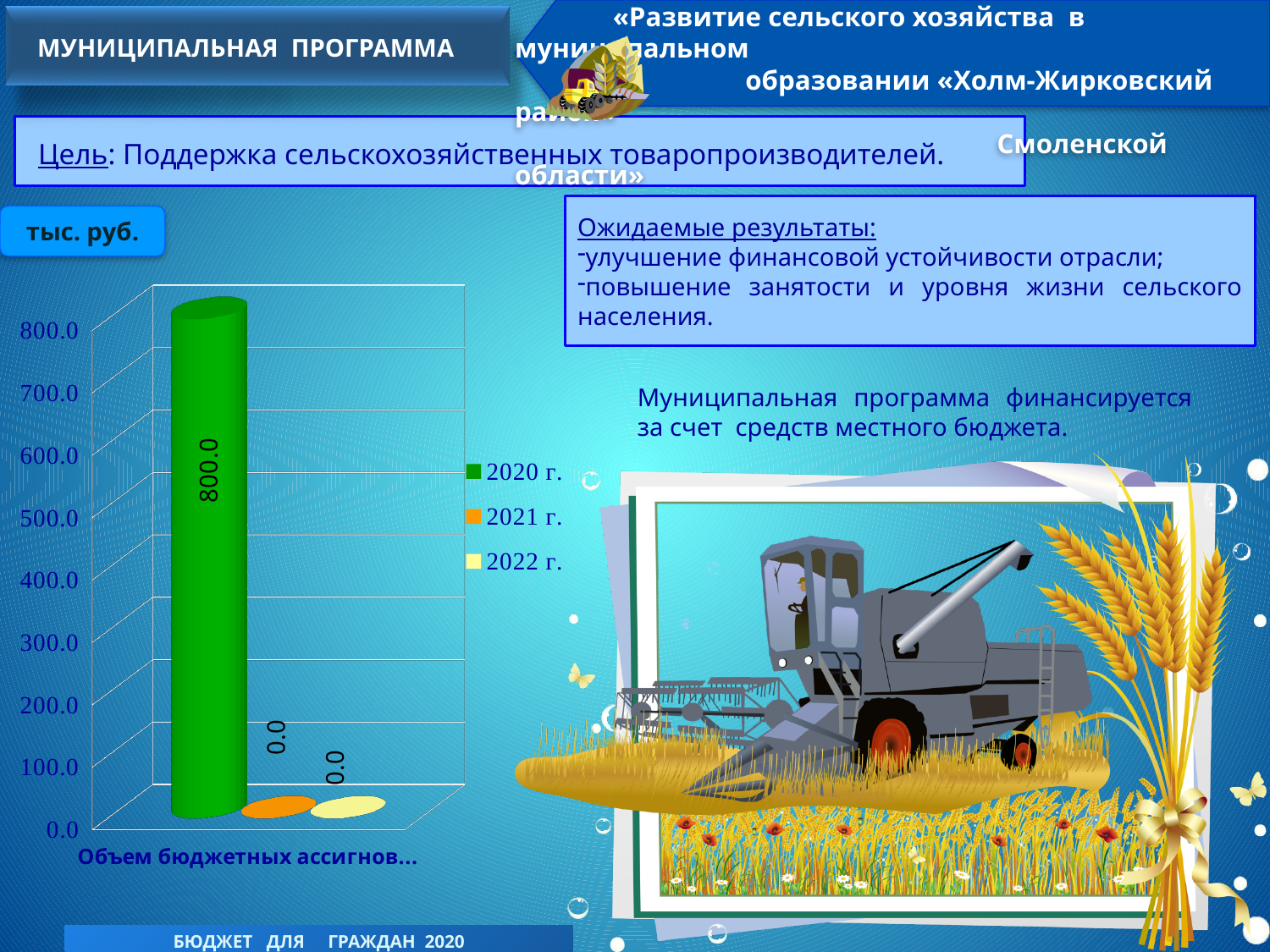
What kind of chart is shown on the slide? bar chart How many series does the chart legend list? 3 Which series has the highest value in the chart? 2020 г. What is the value for the 2022 г. series in the chart? 0.0 What is the value for the 2021 г. series in the chart? 0.0 What is the value for the 2020 г. series in the chart? 800.0 Is the value for 2020 г. greater or less than 700.0? greater What is the difference between the 2020 г. value and the 2021 г. value? 800.0 Which is larger, the value for 2020 г. or the value for 2022 г.? 2020 г. What is the total of the values for 2020 г., 2021 г. and 2022 г.? 800.0 What colour is the bar for the 2020 г. series? green What unit is indicated for the chart values? тыс. руб.